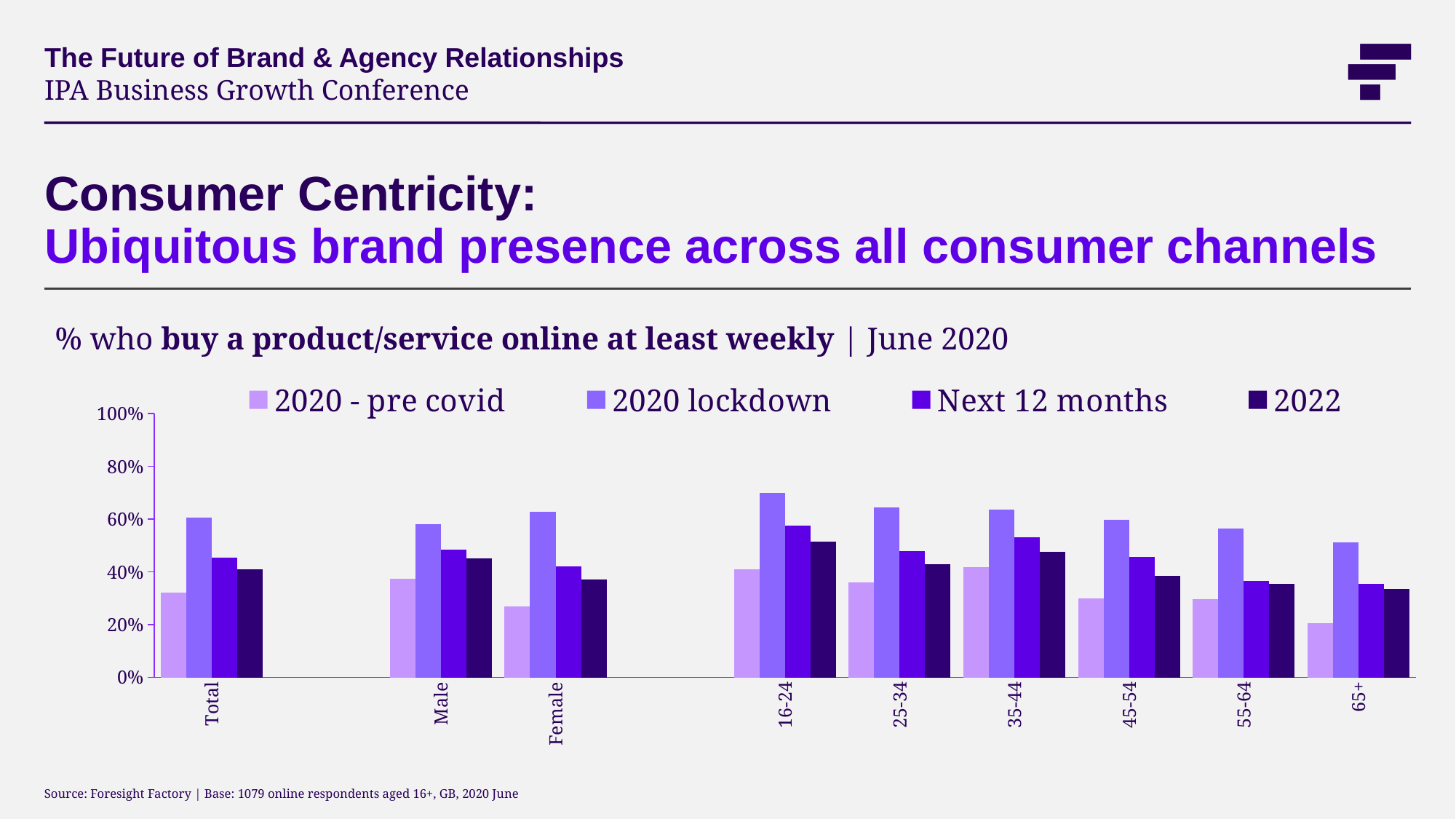
Is the 2020 lockdown value for 16-24 greater or less than 60%? greater Which category has the lowest value for the 2020 - pre covid series? 65+ What is the first series listed in the chart legend? 2020 - pre covid Among the age groups, which has the highest value for the 2020 lockdown series? 16-24 Is the 2020 - pre covid value for 65+ greater or less than 40%? less How many categories are shown along the x axis of the chart? 9 For the 2020 - pre covid series, which is larger: Male or Female? Male Moving from the 16-24 age group to the 65+ age group, do the 2020 lockdown values rise or fall? fall Is the 2020 lockdown value for Total greater or less than 50%? greater What kind of chart is shown on the slide? bar chart How many series does the chart legend list? 4 For the 2020 lockdown series, which is larger: Male or Female? Female